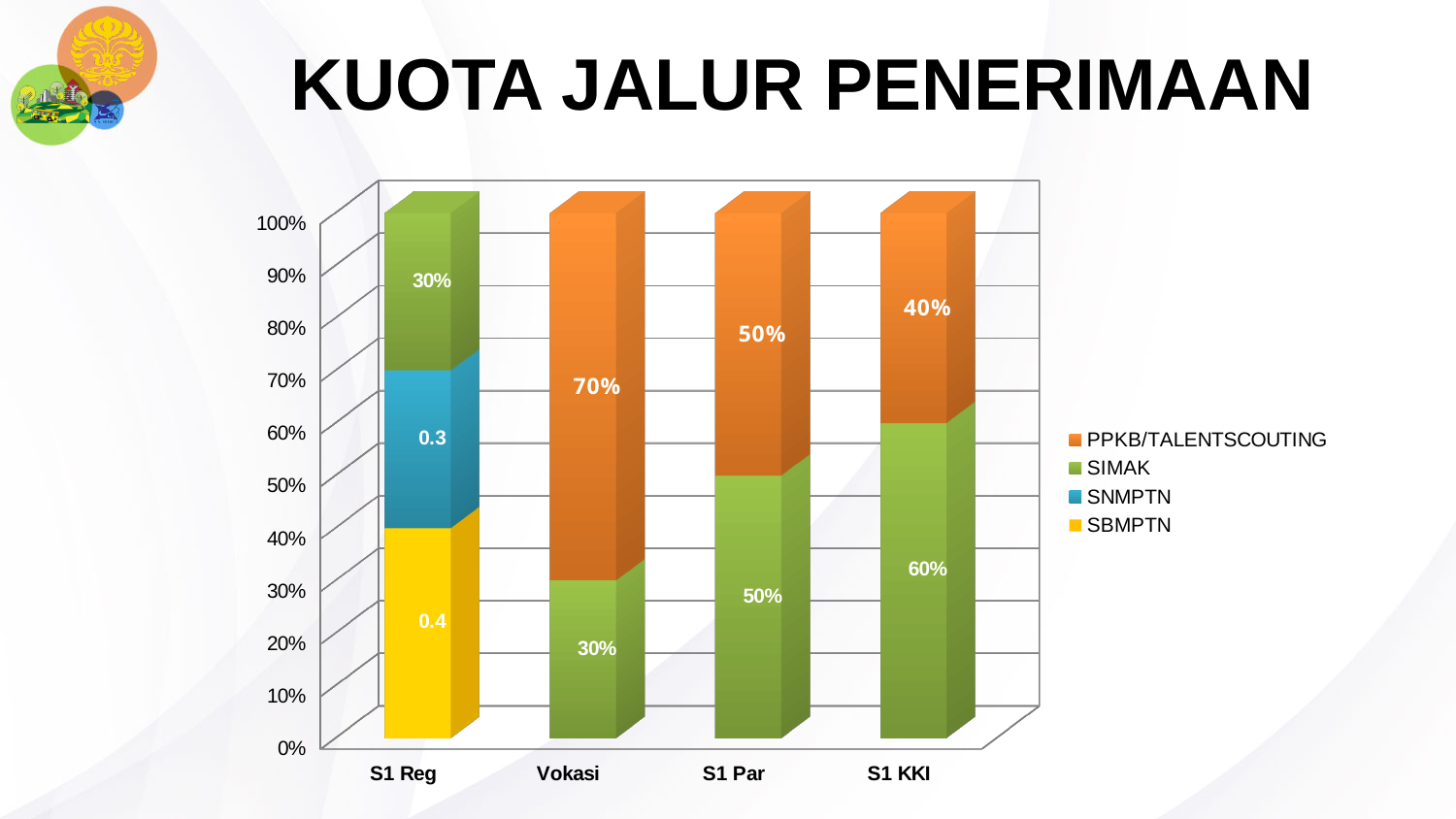
What is the SIMAK value for Vokasi? 30% Which category has the highest PPKB/TALENTSCOUTING value? Vokasi Which category has the highest SIMAK value? S1 KKI How many categories are shown on the x axis? 4 What is the PPKB/TALENTSCOUTING value for Vokasi? 70% What is the title of the chart? KUOTA JALUR PENERIMAAN How many series does the legend list? 4 What kind of chart is shown on the slide? Stacked bar chart What is the difference between the PPKB/TALENTSCOUTING value for Vokasi and for S1 KKI? 30% What is the SIMAK value for S1 KKI? 60% What is the SNMPTN value for S1 Reg? 0.3 What is the SBMPTN value for S1 Reg? 0.4